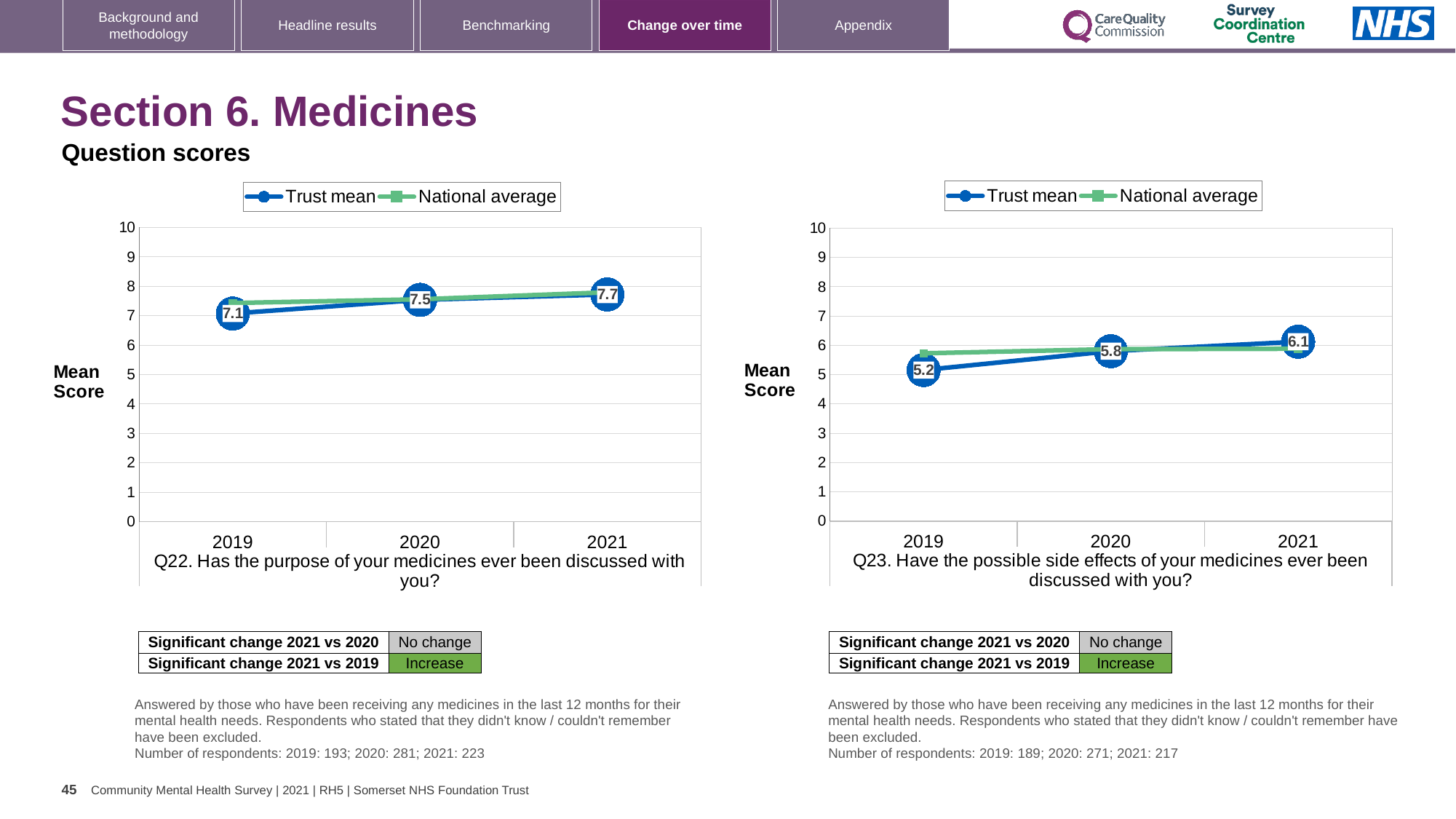
In the right chart (Q23), what is the Trust mean score for 2021? 6.1 Is the Trust mean score for 2019 in the right chart (Q23) greater or less than 6? less In the left chart (Q22), what is the Trust mean score for 2019? 7.1 In the left chart (Q22), what is the difference between the Trust mean scores for 2021 and 2019? 0.6 In the right chart (Q23), what is the Trust mean score for 2020? 5.8 In the right chart (Q23), what is the difference between the Trust mean scores for 2020 and 2019? 0.6 In the right chart (Q23), which year has the lowest Trust mean score? 2019 What kind of chart is the right chart (Q23)? Line chart In the left chart (Q22), what is the Trust mean score for 2021? 7.7 In the right chart (Q23), does the Trust mean rise or fall from 2019 to 2021? Rise In the left chart (Q22), which year has the highest Trust mean score? 2021 How many series does the legend of the left chart (Q22) list? 2